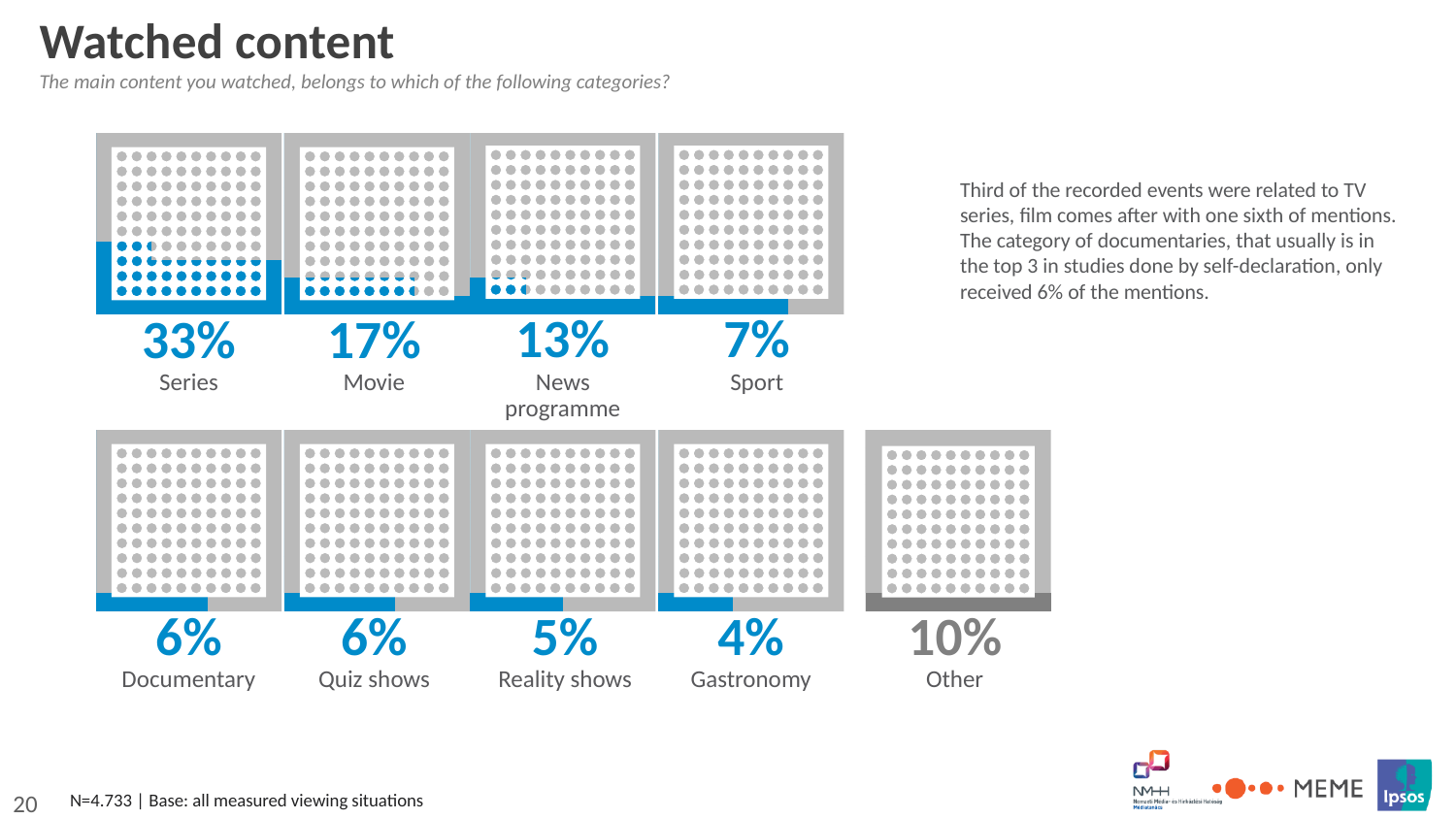
What percentage is shown for News programme? 13% What percentage of watched content belongs to the Series category? 33% What is the combined share of Documentary and Quiz shows? 12% What is the difference in percentage points between Series and Movie? 16 Which is larger, the share for Sport or the share for Other? Other Which named category (excluding Other) has the lowest share? Gastronomy What is the base size (N) stated at the bottom of the slide? N=4.733 What kind of chart is used to show the watched content shares? Waffle chart (dot grid) Which category has the highest share of watched content? Series What is the value shown for Movie? 17% How many content categories are shown on the slide? 9 What is the value shown for Gastronomy? 4%